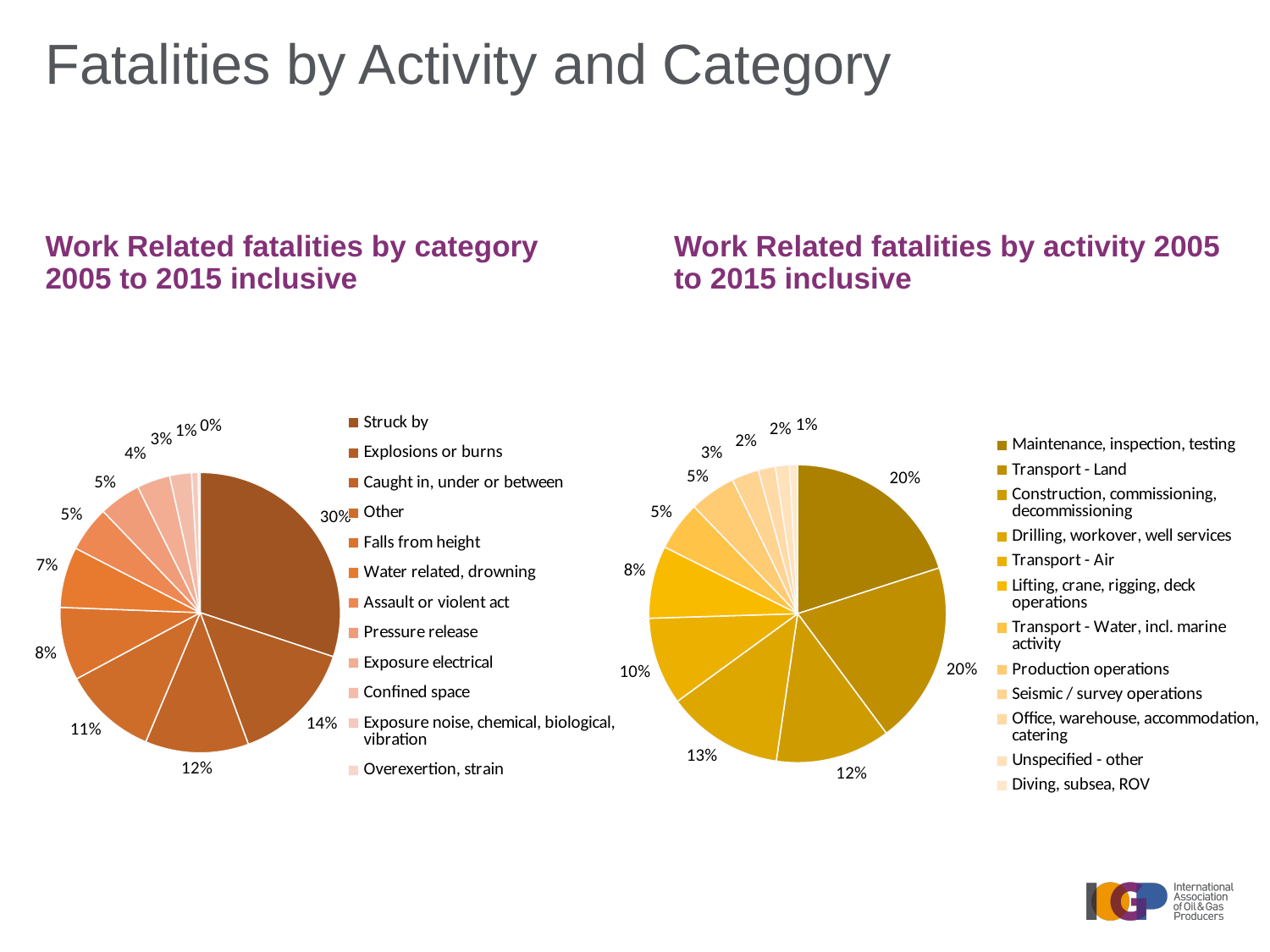
In the 'Work Related fatalities by category' chart, what share is attributed to 'Explosions or burns'? 14% How many categories does the legend of the 'Work Related fatalities by category' chart list? 12 In the 'Work Related fatalities by activity' chart, which activity has the smallest share? Diving, subsea, ROV In the 'Work Related fatalities by category' chart, which category has the largest share? Struck by What is the title of the chart on the right side of the slide? Work Related fatalities by activity 2005 to 2015 inclusive In the 'Work Related fatalities by category' chart, what share of fatalities is attributed to 'Struck by'? 30% How many activities does the legend of the 'Work Related fatalities by activity' chart list? 12 What type of charts are shown on the slide? Pie charts In the 'Work Related fatalities by category' chart, what is the difference in percentage points between 'Struck by' and 'Caught in, under or between'? 18 percentage points In the 'Work Related fatalities by activity' chart, what share is attributed to 'Transport - Air'? 10% In the 'Work Related fatalities by activity' chart, which is larger: the share for 'Transport - Air' or the share for 'Lifting, crane, rigging, deck operations'? Transport - Air